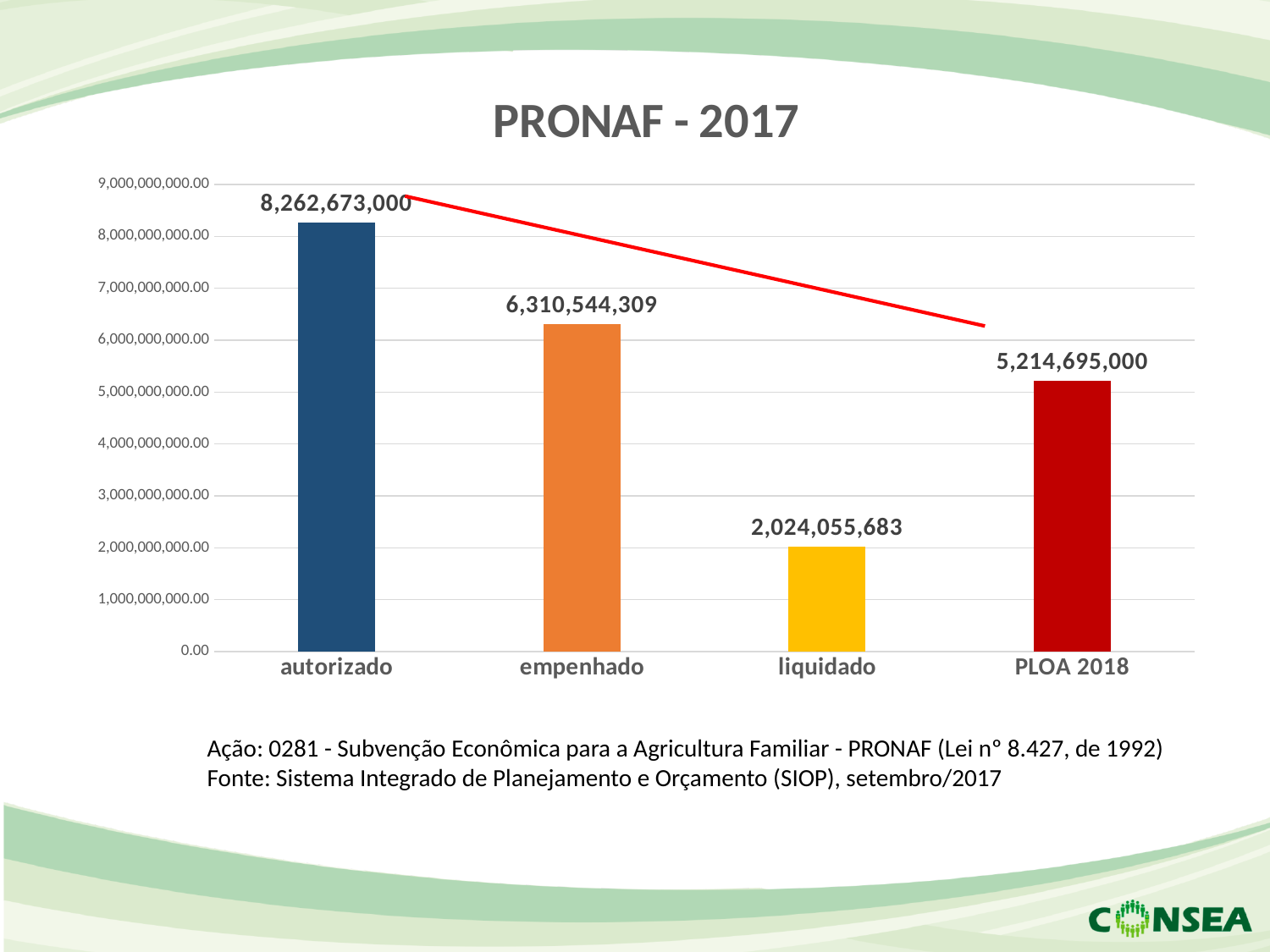
Which category has the highest value? autorizado What kind of chart is shown on the slide? bar chart What is the difference between the values for empenhado and liquidado? 4,286,488,626 Which is larger, the value for empenhado or the value for PLOA 2018? empenhado How many categories are shown on the x axis? 4 Which category has the lowest value? liquidado What is the value for autorizado? 8,262,673,000 What is the value for liquidado? 2,024,055,683 What is the difference between the values for autorizado and empenhado? 1,952,128,691 What is the value for PLOA 2018? 5,214,695,000 What is the value for empenhado? 6,310,544,309 Is the value for PLOA 2018 greater or less than 5,000,000,000.00? greater